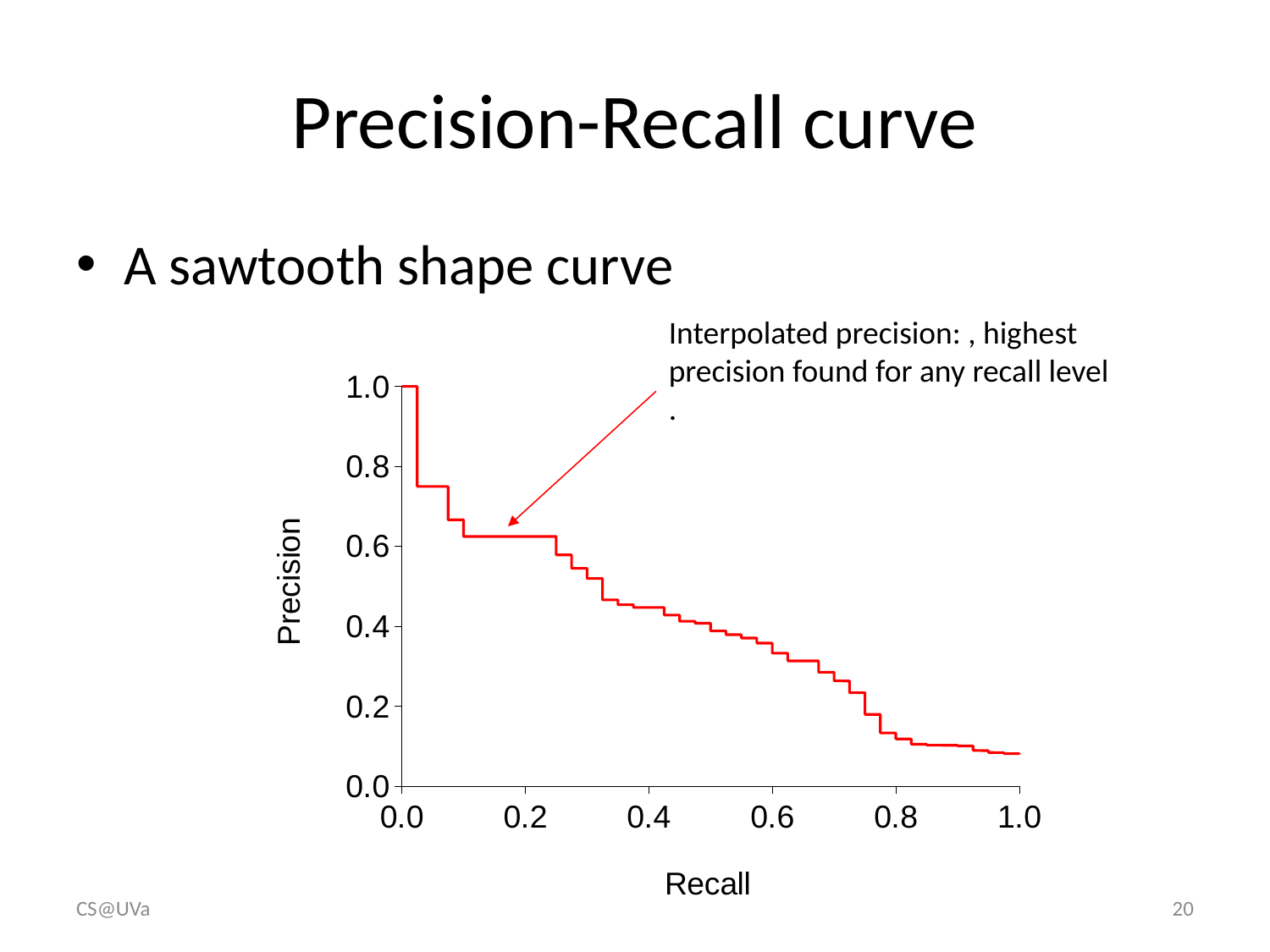
Is the precision at recall 0.1 greater or less than 0.8? less What is the label of the x axis? Recall Is the precision at recall 0.6 greater or less than 0.4? less Is the precision at recall 0.8 greater or less than 0.2? less Which has the higher precision: recall 0.2 or recall 0.8? recall 0.2 Does precision rise or fall as recall increases along the x axis? fall What is the title of the chart on the slide? Precision-Recall curve What is the precision value at the start of the curve, at recall 0.0? 1.0 What kind of chart is shown on the slide? line chart